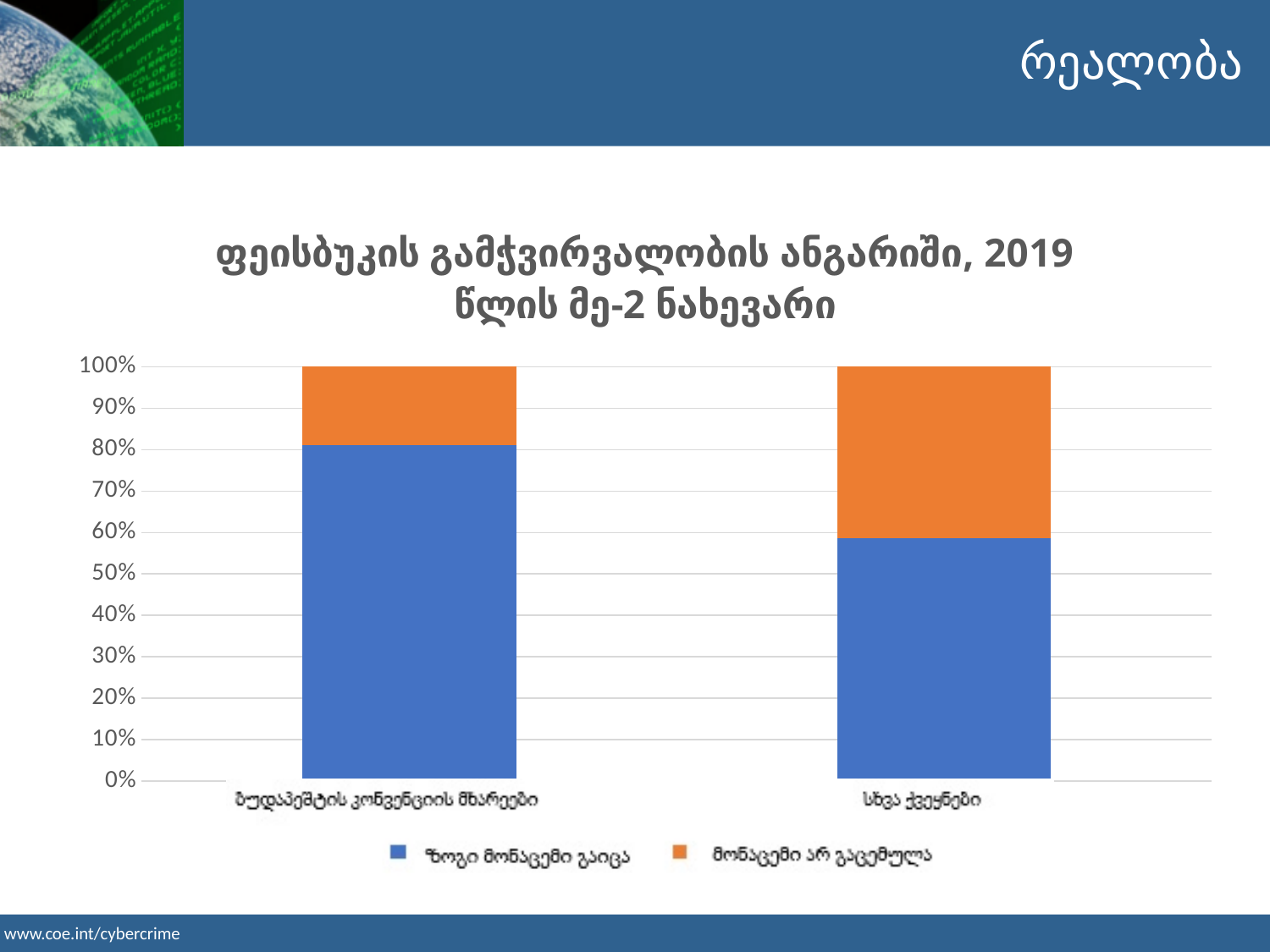
Which category has the larger share of ზოგი მონაცემი გაიცა, ბუდაპეშტის კონვენციის მხარეები or სხვა ქვეყნები? ბუდაპეშტის კონვენციის მხარეები How many categories are shown on the x axis of the chart? 2 Which series is shown in blue in the chart? ზოგი მონაცემი გაიცა Does the share of ზოგი მონაცემი გაიცა rise or fall from ბუდაპეშტის კონვენციის მხარეები to სხვა ქვეყნები? fall Is the value of ზოგი მონაცემი გაიცა for სხვა ქვეყნები greater or less than 50%? greater Is the value of ზოგი მონაცემი გაიცა for სხვა ქვეყნები greater or less than 70%? less What is the total height of the stacked bar for ბუდაპეშტის კონვენციის მხარეები? 100% What is the title of the chart? ფეისბუკის გამჭვირვალობის ანგარიში, 2019 წლის მე-2 ნახევარი Which category has the larger share of მონაცემი არ გაცემულა? სხვა ქვეყნები How many series does the chart legend list? 2 What kind of chart is shown on the slide? stacked bar chart Is the value of ზოგი მონაცემი გაიცა for ბუდაპეშტის კონვენციის მხარეები greater or less than 70%? greater